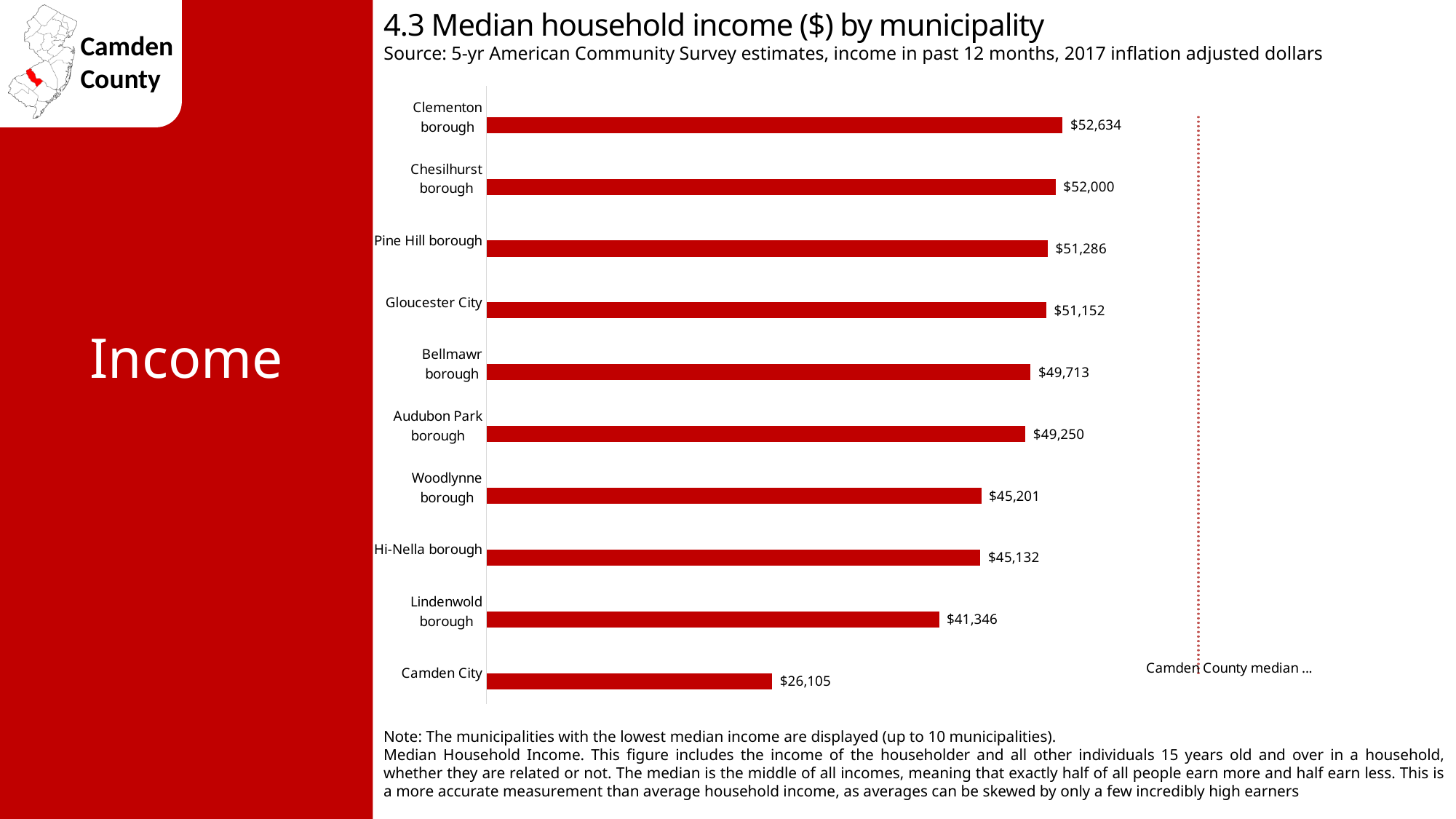
How many municipalities are shown on the chart? 10 What is the title of the chart? 4.3 Median household income ($) by municipality What is the median household income for Lindenwold borough? $41,346 What type of chart is used to show median household income by municipality? Bar chart What is the median household income for Clementon borough? $52,634 What is the difference in median household income between Pine Hill borough and Gloucester City? $134 What is the median household income for Camden City? $26,105 Which municipality has the lowest median household income shown on the chart? Camden City Which has a higher median household income, Bellmawr borough or Lindenwold borough? Bellmawr borough Which municipality has the highest median household income shown on the chart? Clementon borough What is the difference in median household income between Clementon borough and Camden City? $26,529 What is the median household income for Woodlynne borough? $45,201